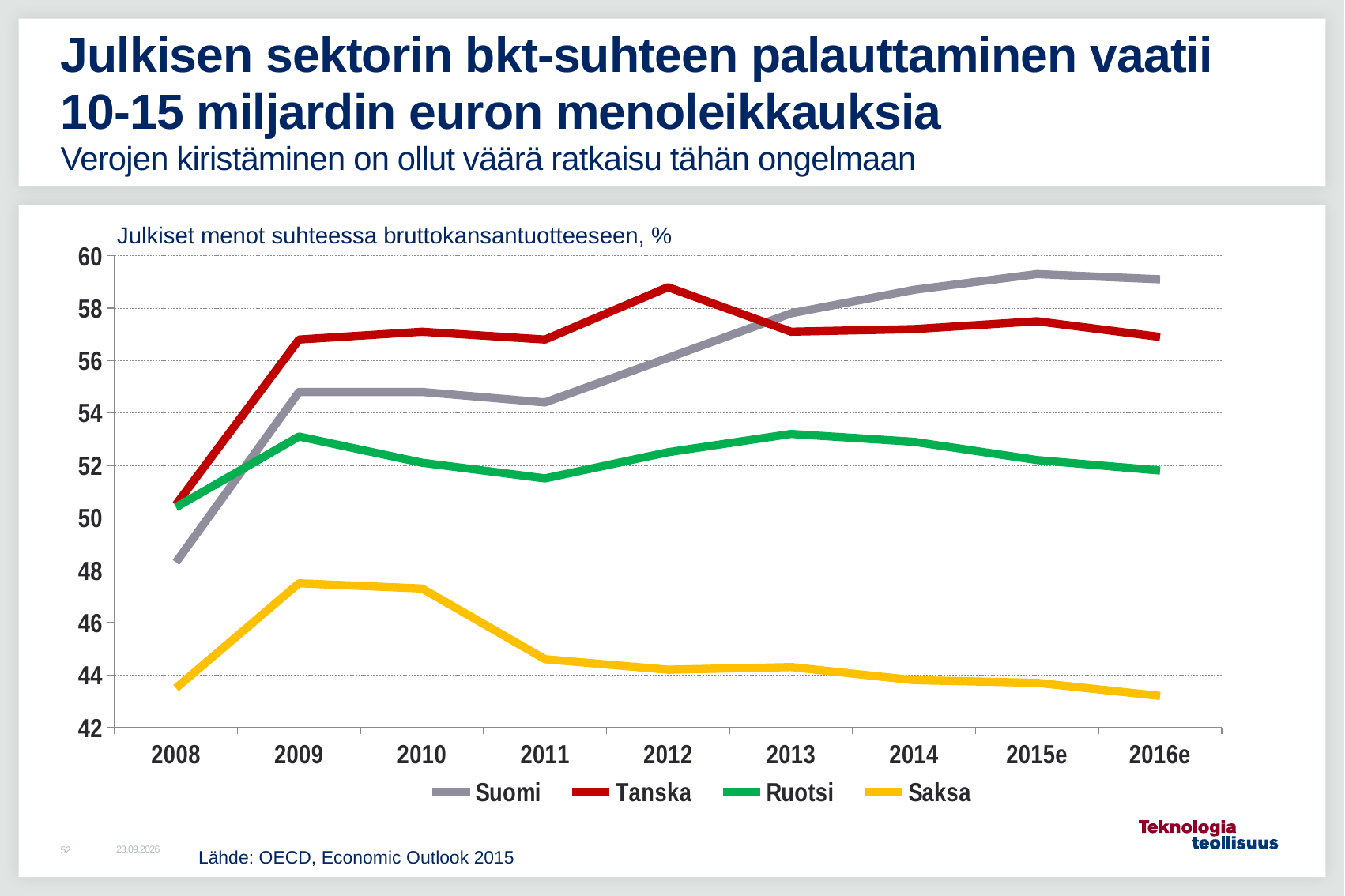
What colour is the line for Ruotsi? green What kind of chart is shown on the slide? line chart Does the value for Saksa rise or fall from 2009 to 2016e? fall How many years are shown on the x axis? 9 Which country has the lowest value in 2008? Saksa Is the value for Tanska in 2012 greater or less than 58? greater Is the value for Suomi in 2008 greater or less than 50? less Is the value for Saksa in 2009 greater or less than 46? greater How many series does the legend list? 4 Which is larger in 2016e, the value for Suomi or the value for Tanska? Suomi Which country has the highest value in 2012? Tanska Which country has the highest value in 2015e? Suomi